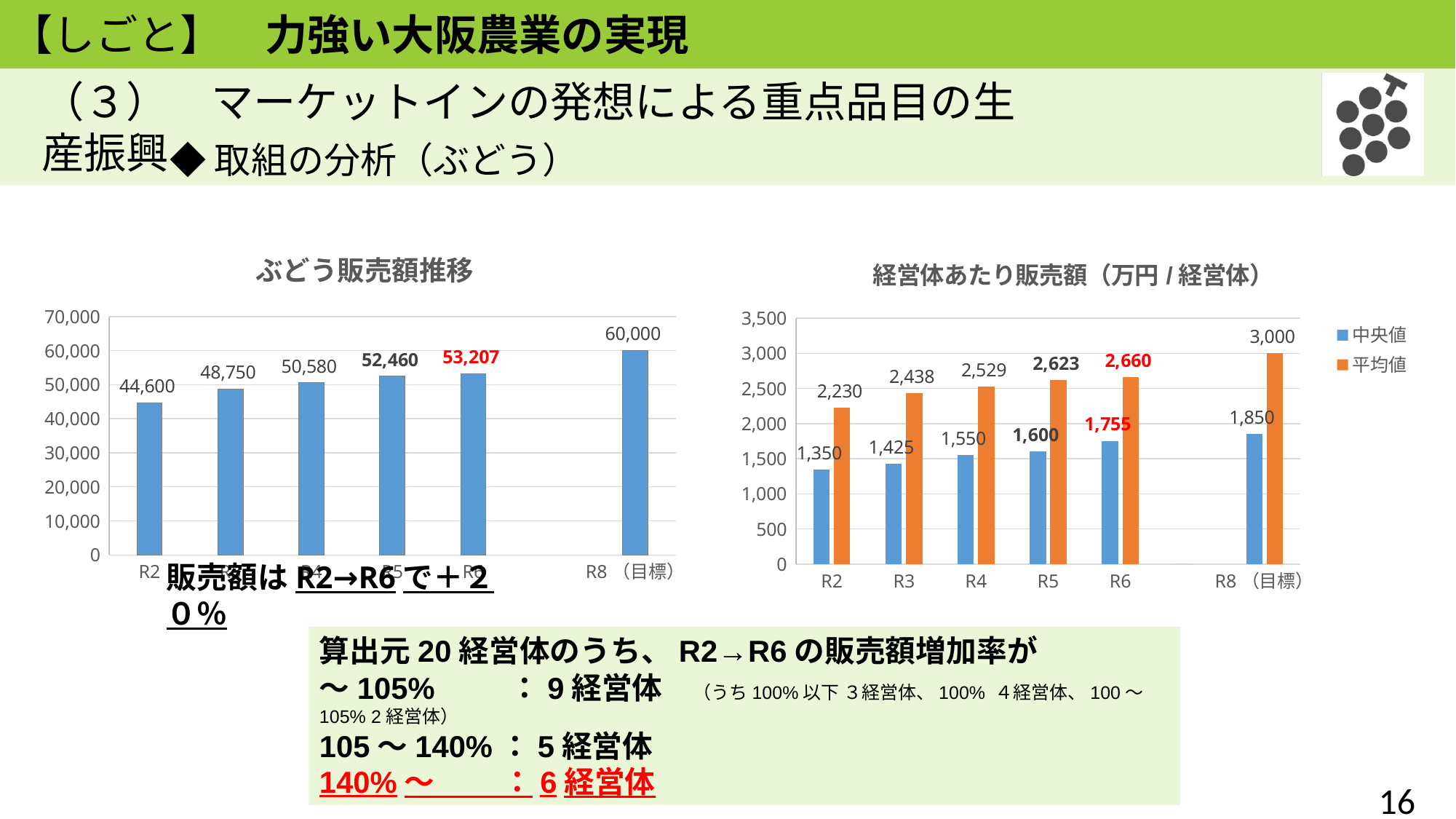
In the chart titled 経営体あたり販売額（万円/経営体）, what is the 中央値 value for R6? 1,755 In the chart titled 経営体あたり販売額（万円/経営体）, which is larger for R5: 中央値 or 平均値? 平均値 In the chart titled ぶどう販売額推移, what is the difference between the R8（目標） value and the R2 value? 15,400 In the chart titled 経営体あたり販売額（万円/経営体）, how many series does the legend list? 2 In the chart titled ぶどう販売額推移, what is the value for R8（目標）? 60,000 In the chart titled 経営体あたり販売額（万円/経営体）, what is the difference between the 平均値 and 中央値 values for R8（目標）? 1,150 In the chart titled ぶどう販売額推移, do the values rise or fall from R2 to R8（目標）? rise In the chart titled ぶどう販売額推移, how many bars are plotted? 6 In the chart titled ぶどう販売額推移, what is the value for R2? 44,600 In the chart titled 経営体あたり販売額（万円/経営体）, what is the 平均値 value for R4? 2,529 In the chart titled ぶどう販売額推移, which category has the lowest value? R2 What kind of chart is the chart titled 経営体あたり販売額（万円/経営体）? bar chart